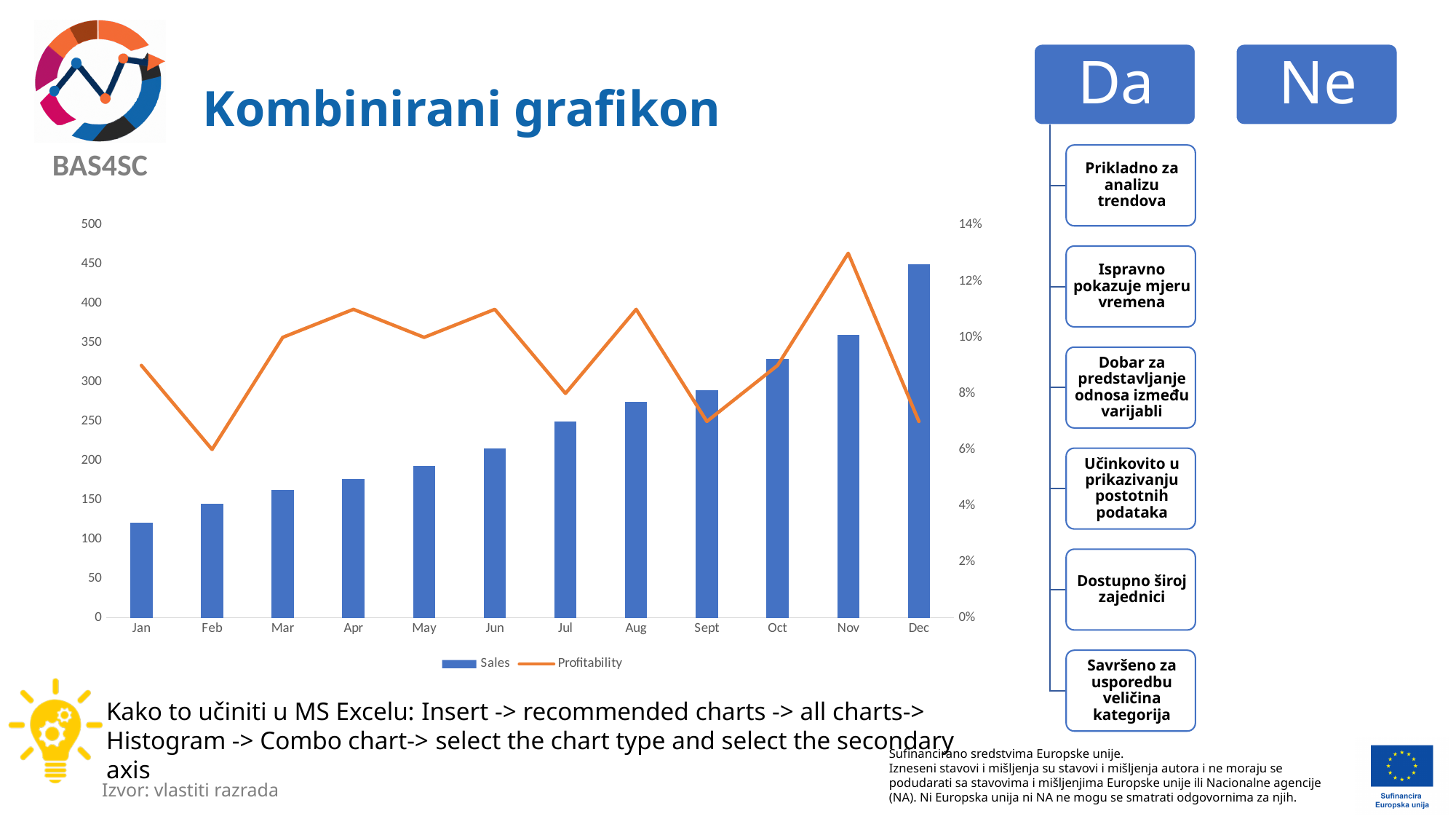
Which month has the lowest Profitability value? Feb How many months are shown on the x axis? 12 Is the Profitability value for Nov greater or less than 12%? greater Which month has the highest Profitability value? Nov Which month has higher Sales, Sept or Oct? Oct What are the two series named in the legend? Sales and Profitability Do the Sales bars rise or fall from Jan to Dec? Rise Is the Sales value for Dec greater or less than 400? greater What kind of chart is shown on the slide? A combination chart with bars and a line How many series does the legend list? 2 Which month has the lowest Sales bar? Jan Which month has the highest Sales bar? Dec